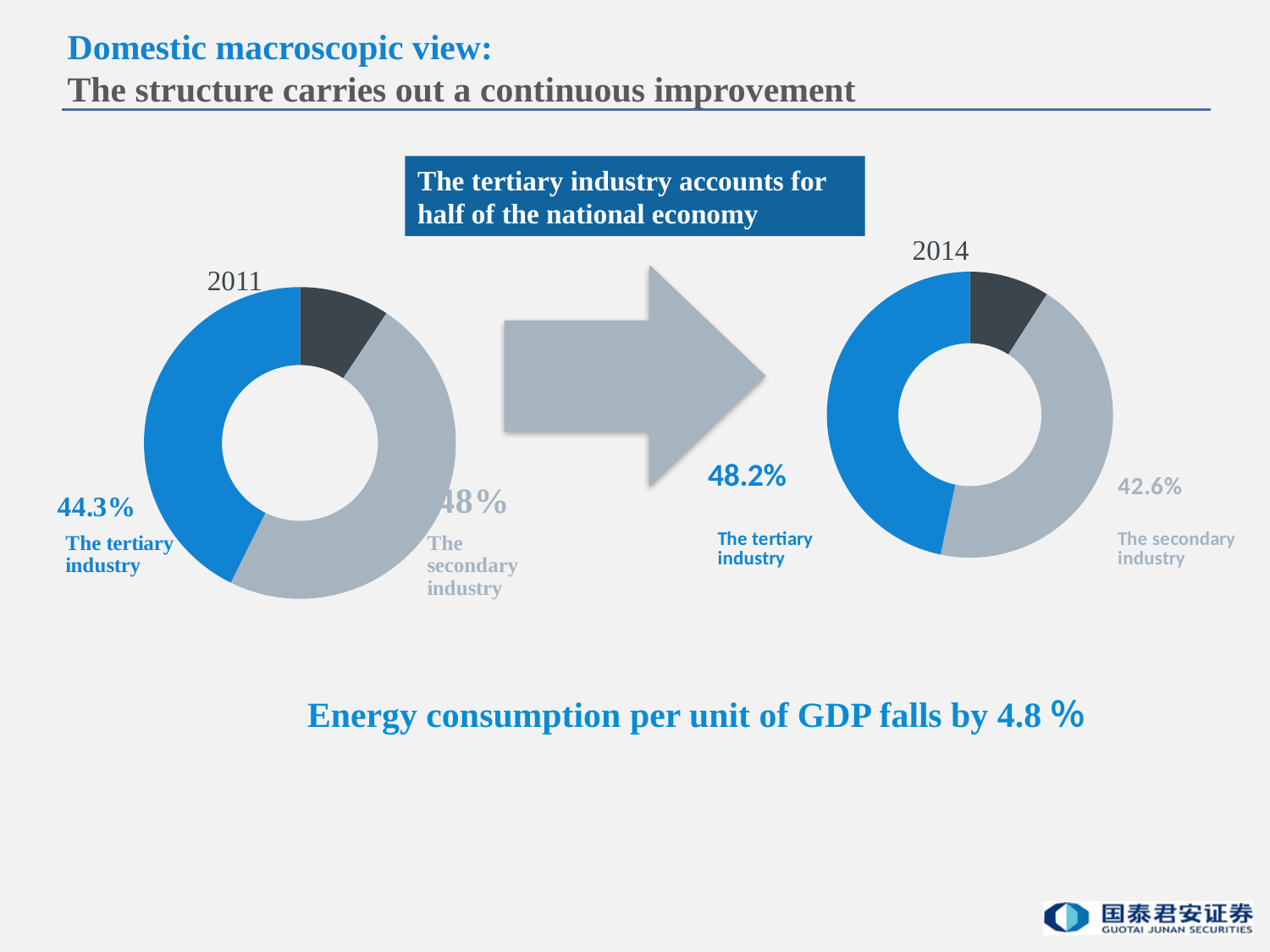
In the 2011 chart, which is larger, the tertiary industry or the secondary industry? The secondary industry Did the tertiary industry share rise or fall from the 2011 chart to the 2014 chart? Rise In the 2014 chart, what share does the tertiary industry account for? 48.2% In the 2014 chart, which is larger, the tertiary industry or the secondary industry? The tertiary industry In the 2014 chart, what share does the secondary industry account for? 42.6% Which year is shown by the chart on the right side of the slide? 2014 What kind of chart is used to show the 2011 and 2014 industry structure? Pie (donut) chart How many slices does the 2014 chart have? 3 In the 2011 chart, what share does the tertiary industry account for? 44.3% In the 2011 chart, what share does the secondary industry account for? 48% In the 2014 chart, what is the difference between the tertiary industry share and the secondary industry share? 5.6% By how many percentage points did the tertiary industry share change from the 2011 chart to the 2014 chart? 3.9%